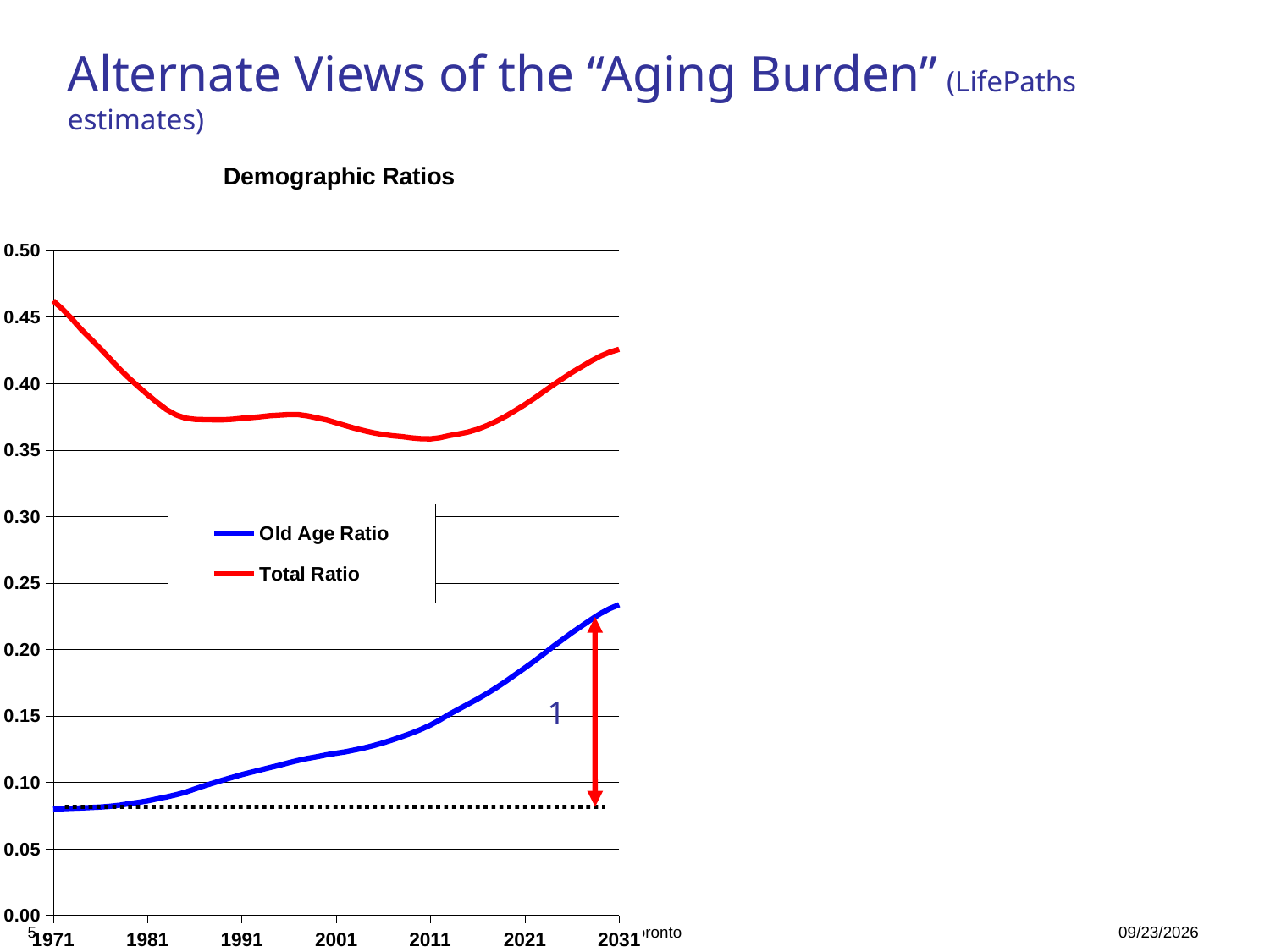
What are the two series named in the legend of the chart? Old Age Ratio and Total Ratio Does the Old Age Ratio rise or fall from 1971 to 2031? rises Does the Total Ratio rise or fall from 1971 to 2011? falls In which year shown on the x axis is the Total Ratio at its lowest? 2011 Is the Old Age Ratio in 1971 greater or less than 0.10? less What kind of chart is shown on the slide? line chart What is the title of the chart on the slide? Demographic Ratios Is the Total Ratio in 1971 greater or less than 0.40? greater Is the Old Age Ratio in 2031 greater or less than 0.20? greater In 2011, which is larger, the Old Age Ratio or the Total Ratio? Total Ratio How many series does the legend of the Demographic Ratios chart list? 2